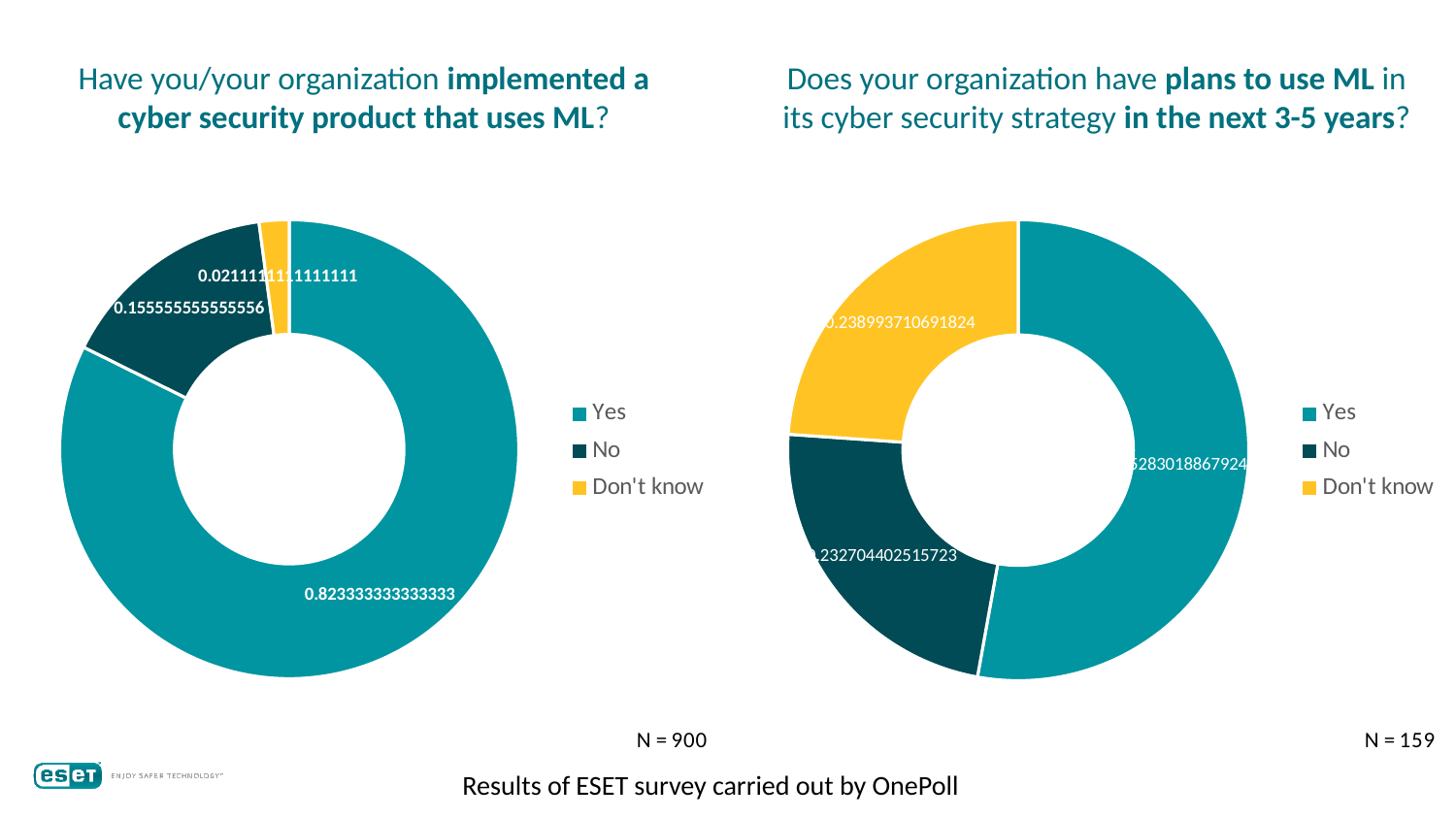
How many categories does the legend of the right chart (plans to use ML in the next 3-5 years) list? 3 In the left chart (implemented a cyber security product that uses ML), which category has the smallest share? Don't know In the left chart (implemented a cyber security product that uses ML), what is the value for No? 0.155555555555556 What is the sample size (N) shown for the right chart (plans to use ML in the next 3-5 years)? N = 159 What type of chart is used on the left side of the slide? Donut chart How many slices does the left chart (implemented a cyber security product that uses ML) have? 3 In the right chart (plans to use ML in the next 3-5 years), which category has the largest share? Yes In the left chart (implemented a cyber security product that uses ML), which category has the largest share? Yes In the left chart (implemented a cyber security product that uses ML), what is the value for Yes? 0.823333333333333 In the left chart (implemented a cyber security product that uses ML), which is larger, No or Don't know? No In the left chart (implemented a cyber security product that uses ML), what is the difference between the Yes and No values? 0.667777777777777 Which colour represents the Don't know category in both charts? Yellow